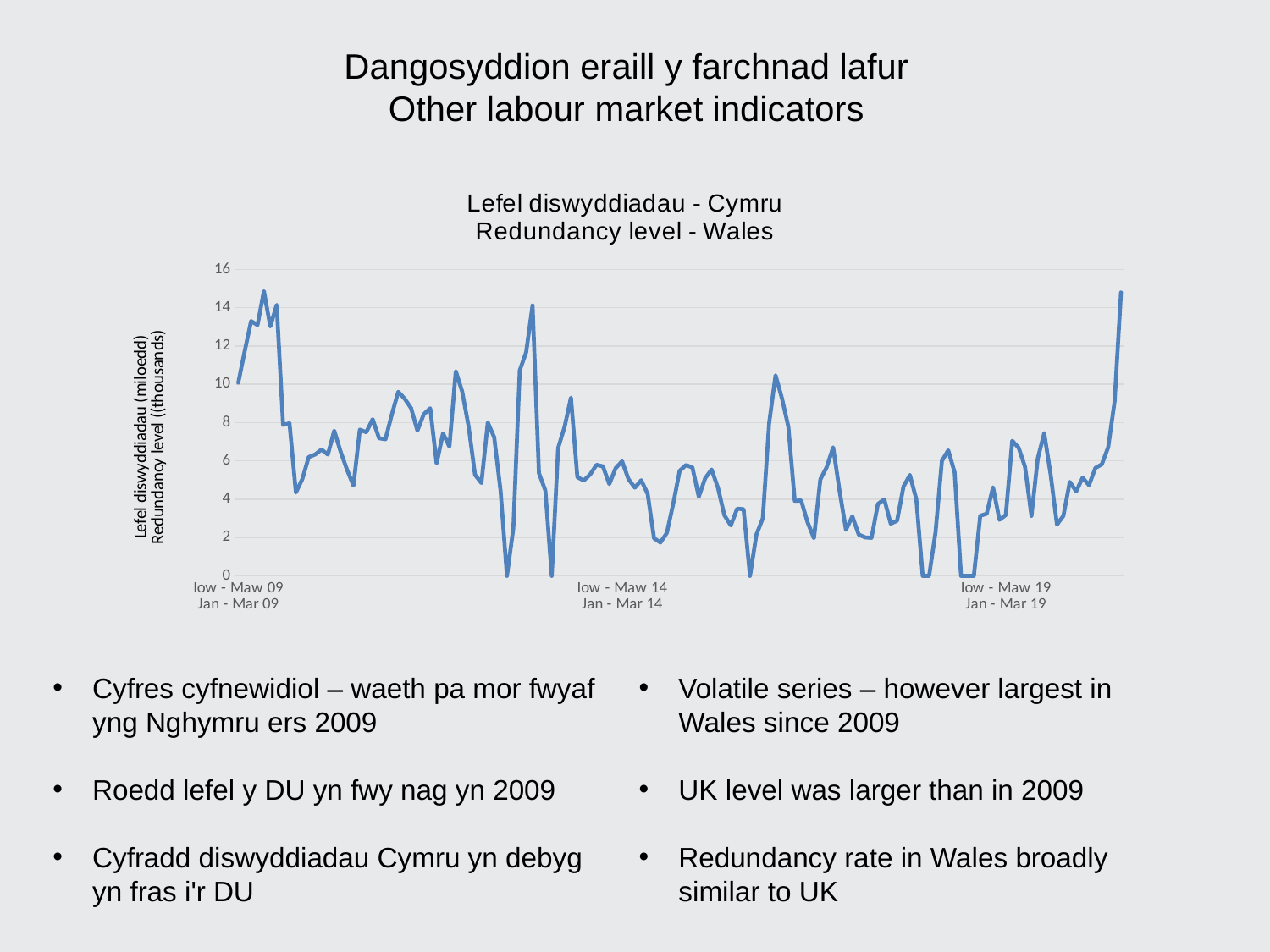
Is the value at Jan - Mar 14 greater or less than 10? less What is the English label on the vertical axis of the chart? Redundancy level ((thousands) What kind of chart is shown on the slide? line chart Is the value at Jan - Mar 19 greater or less than 8? less Is the value at Jan - Mar 09 greater or less than the value at Jan - Mar 19? greater Is the value at Jan - Mar 09 greater or less than 8? greater What is the highest value shown on the vertical axis? 16 How many period labels are printed along the horizontal axis? 3 What is the English title of the chart? Redundancy level - Wales